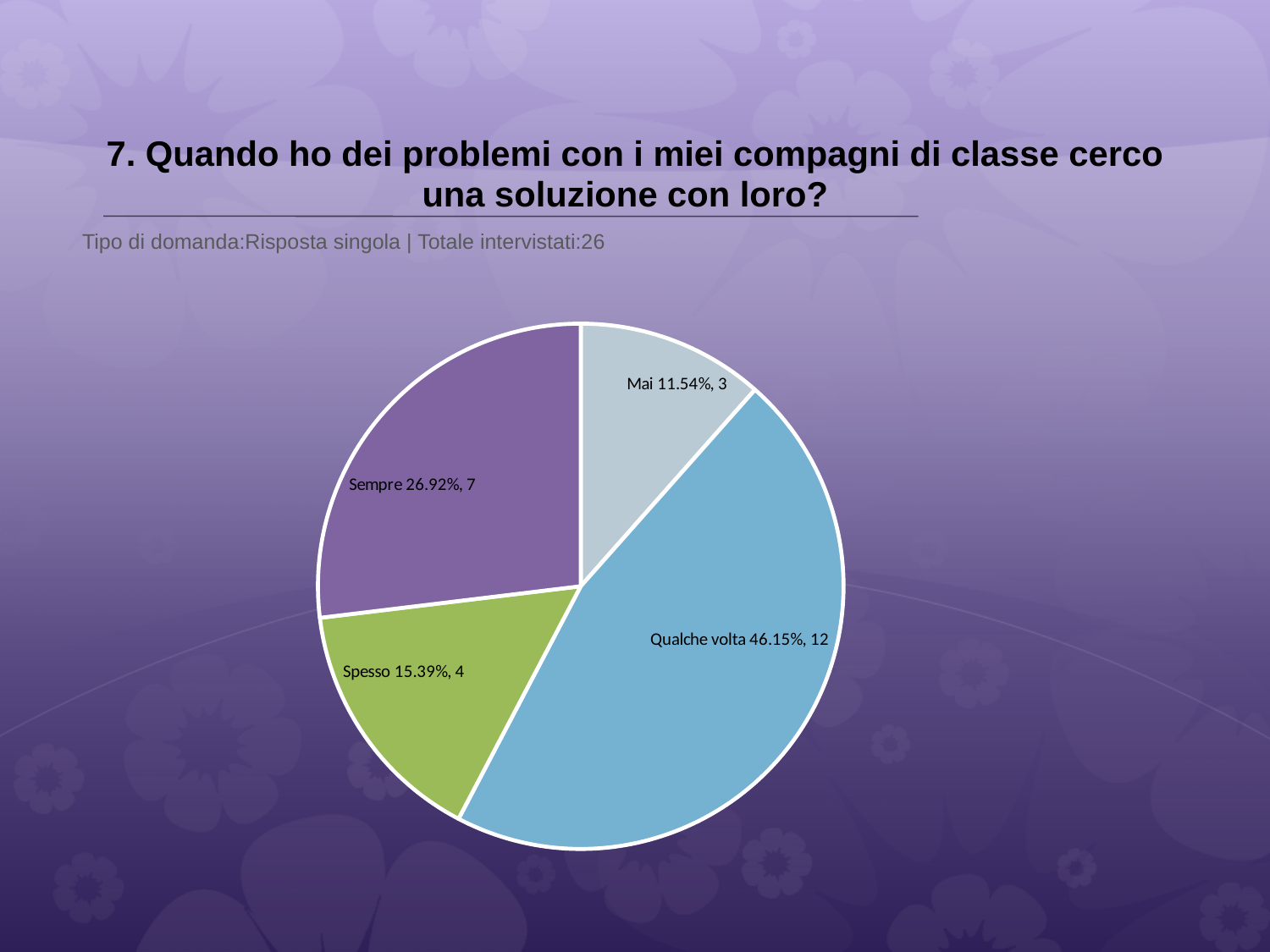
Which category has the largest slice? Qualche volta What percentage share does the 'Mai' slice have? 11.54% Which category has the smallest slice? Mai What is the difference in respondent count between 'Qualche volta' and 'Sempre'? 5 Which has more respondents, 'Spesso' or 'Mai'? Spesso How many respondents answered 'Spesso'? 4 How many slices does the pie chart have? 4 What percentage share does the 'Qualche volta' slice have? 46.15% What colour is the 'Qualche volta' slice? blue What kind of chart is shown on the slide? pie chart How many respondents answered 'Sempre'? 7 What is the total number of respondents across all slices? 26